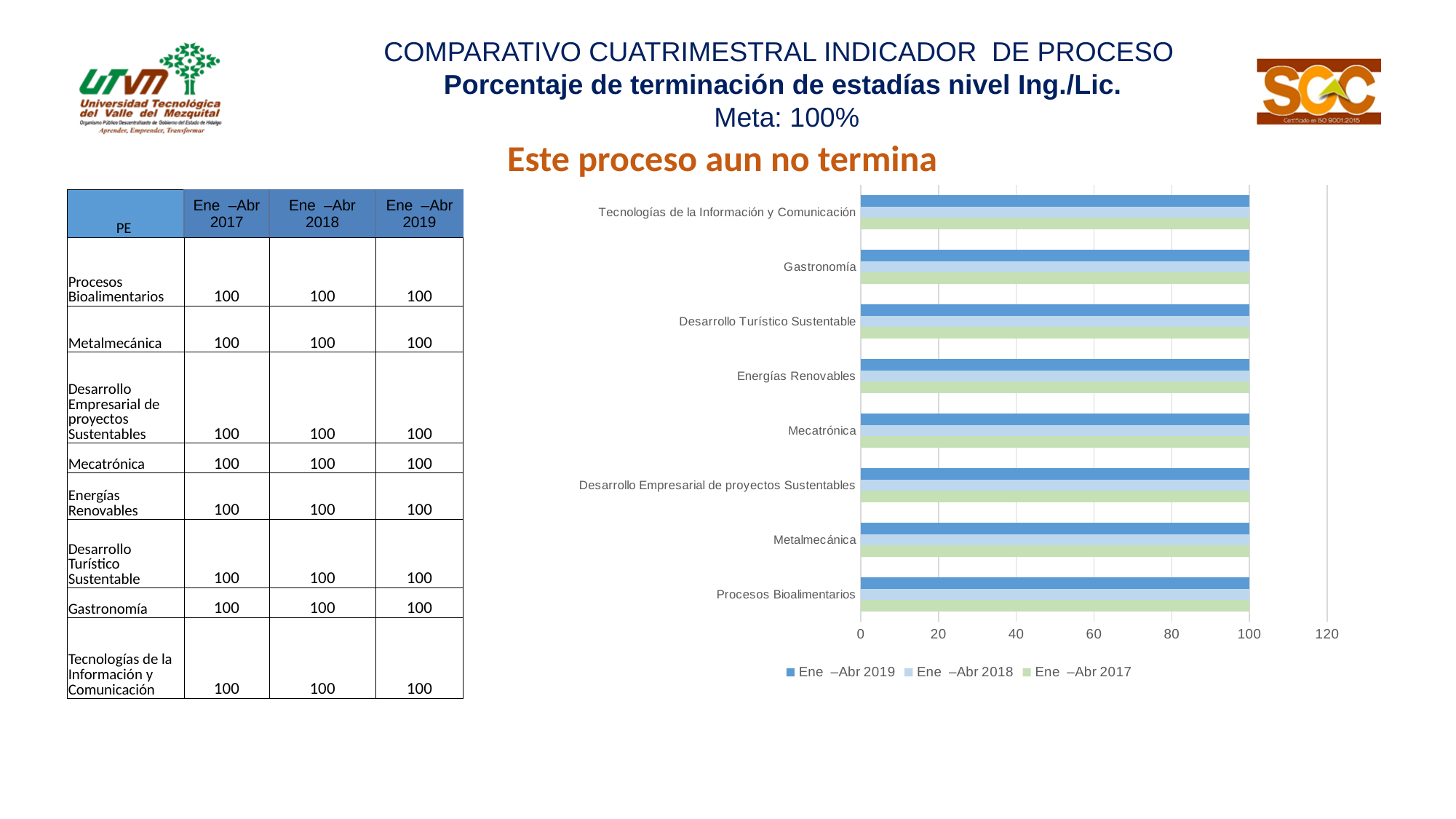
Is the value for Energías Renovables in the Ene –Abr 2017 series greater or less than 120? less Which series is listed first in the chart legend? Ene –Abr 2019 What is the value for Mecatrónica in the Ene –Abr 2019 series? 100 What is the highest value shown on the chart's horizontal axis? 120 What is the value for Gastronomía in the Ene –Abr 2017 series? 100 Does the value for Desarrollo Turístico Sustentable change between the Ene –Abr 2017 and Ene –Abr 2019 series? No How many series does the chart legend list? 3 How many categories (programas educativos) are plotted on the chart? 8 Is the value for Metalmecánica in the Ene –Abr 2019 series greater or less than 80? greater What is the difference between the Ene –Abr 2019 and Ene –Abr 2017 values for Procesos Bioalimentarios? 0 What kind of chart is shown on the slide? bar chart What is the value for Tecnologías de la Información y Comunicación in the Ene –Abr 2018 series? 100